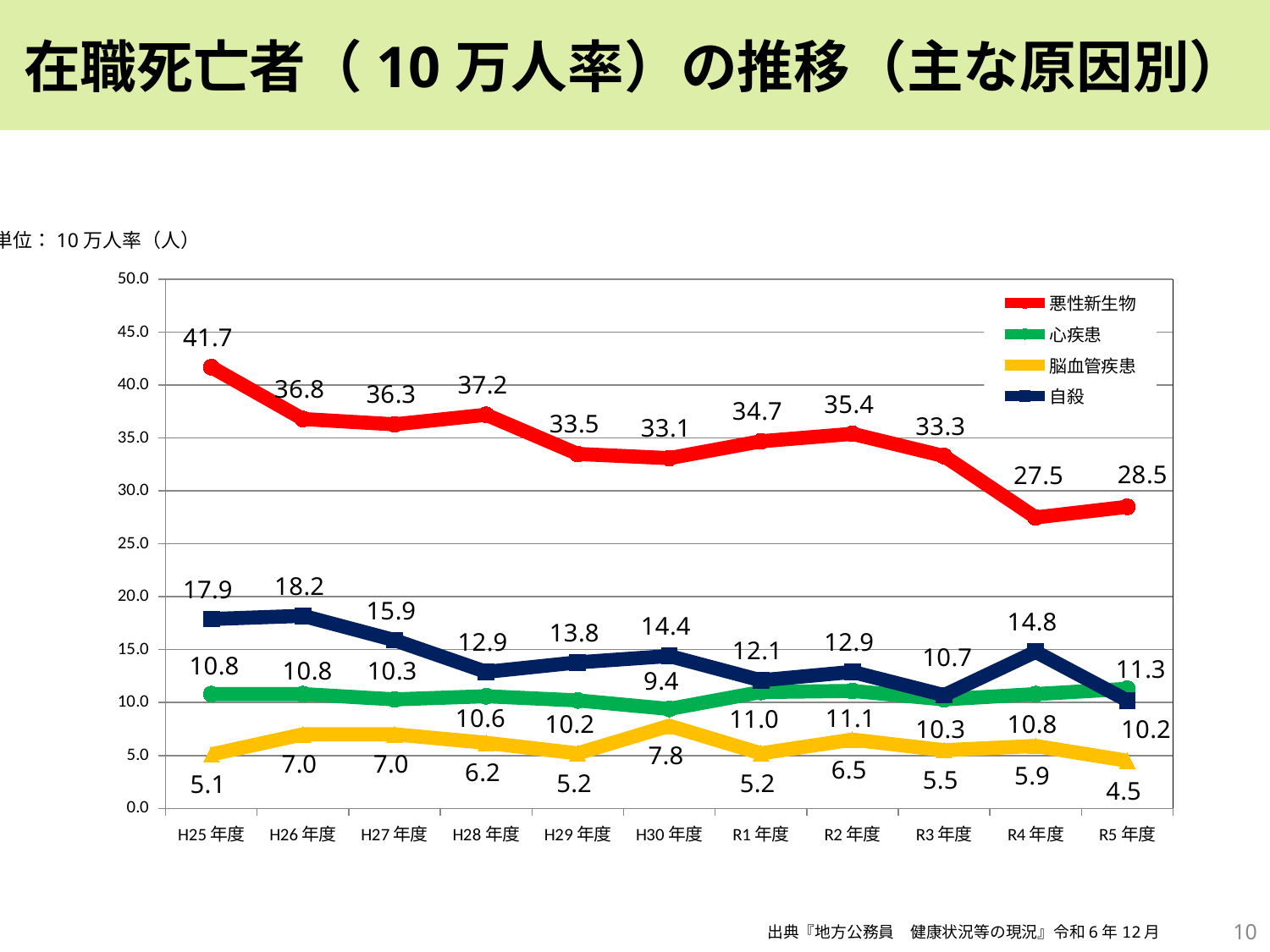
What is the value for 悪性新生物 in R5年度? 28.5 What is the value for 脳血管疾患 in H30年度? 7.8 In which fiscal year is the value for 脳血管疾患 the lowest? R5年度 What type of chart is shown on the slide? line chart What is the value for 悪性新生物 in H25年度? 41.7 In which fiscal year is the value for 悪性新生物 the lowest? R4年度 Does the value for 悪性新生物 generally rise or fall from H25年度 to R5年度? fall How many series does the legend list? 4 How many fiscal years are plotted along the x axis? 11 What is the value for 自殺 in H26年度? 18.2 What is the difference between the 悪性新生物 values in H25年度 and R5年度? 13.2 Which is larger in R4年度, the value for 自殺 or the value for 脳血管疾患? 自殺